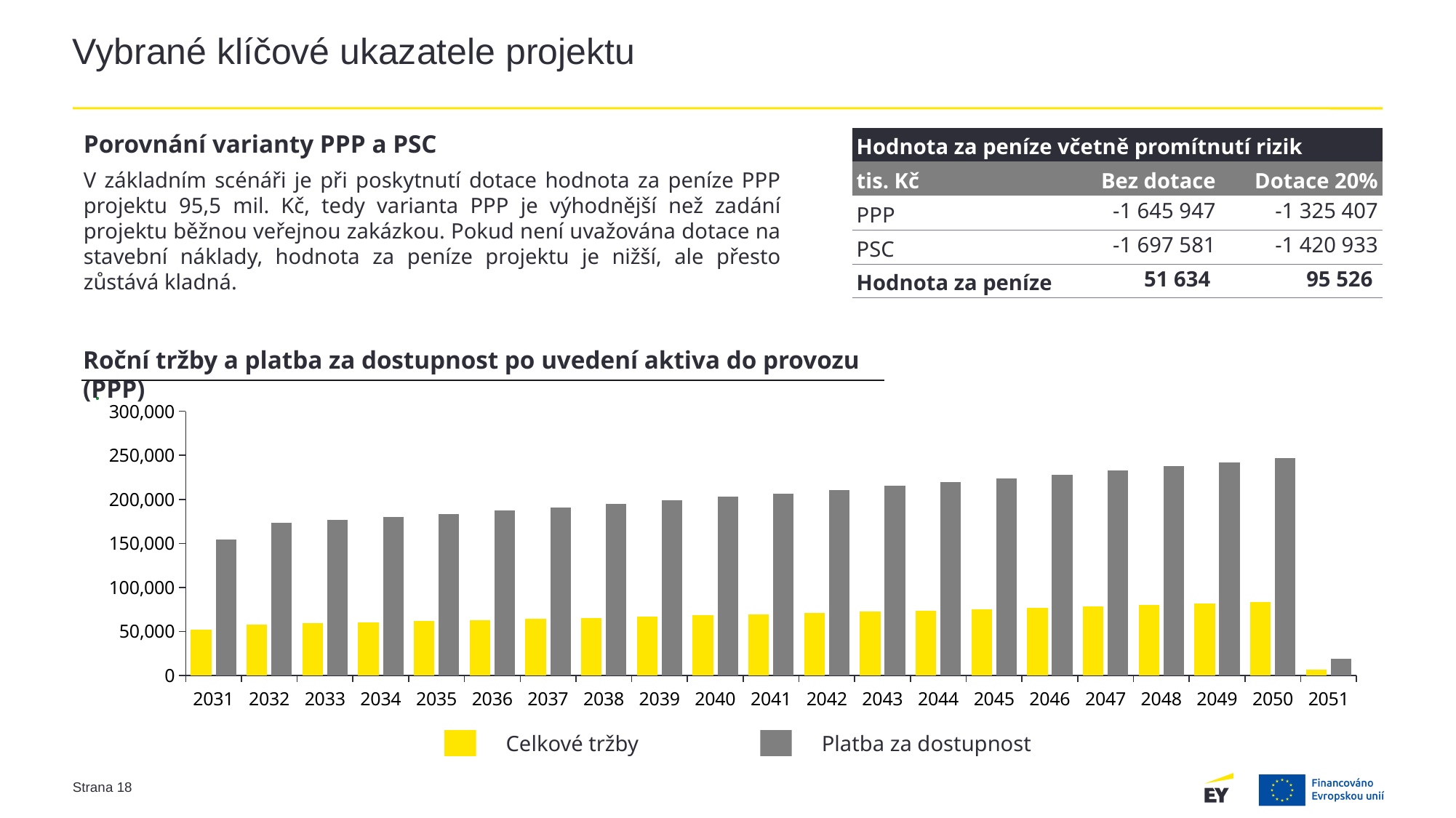
Is the value for Platba za dostupnost in 2031 greater or less than 200,000? less In which year is the value for Platba za dostupnost lowest? 2051 What kind of chart is shown on the slide? bar chart In 2040, which is larger: Celkové tržby or Platba za dostupnost? Platba za dostupnost In which year is the value for Celkové tržby lowest? 2051 Is the value for Platba za dostupnost in 2050 greater or less than 200,000? greater How many years are shown on the x axis of the chart? 21 Is the value for Celkové tržby in 2050 greater or less than 100,000? less How many series does the legend of the chart list? 2 In which year is the value for Platba za dostupnost highest? 2050 Which series is shown in yellow in the chart? Celkové tržby Do the values for Platba za dostupnost rise or fall from 2031 to 2050? rise